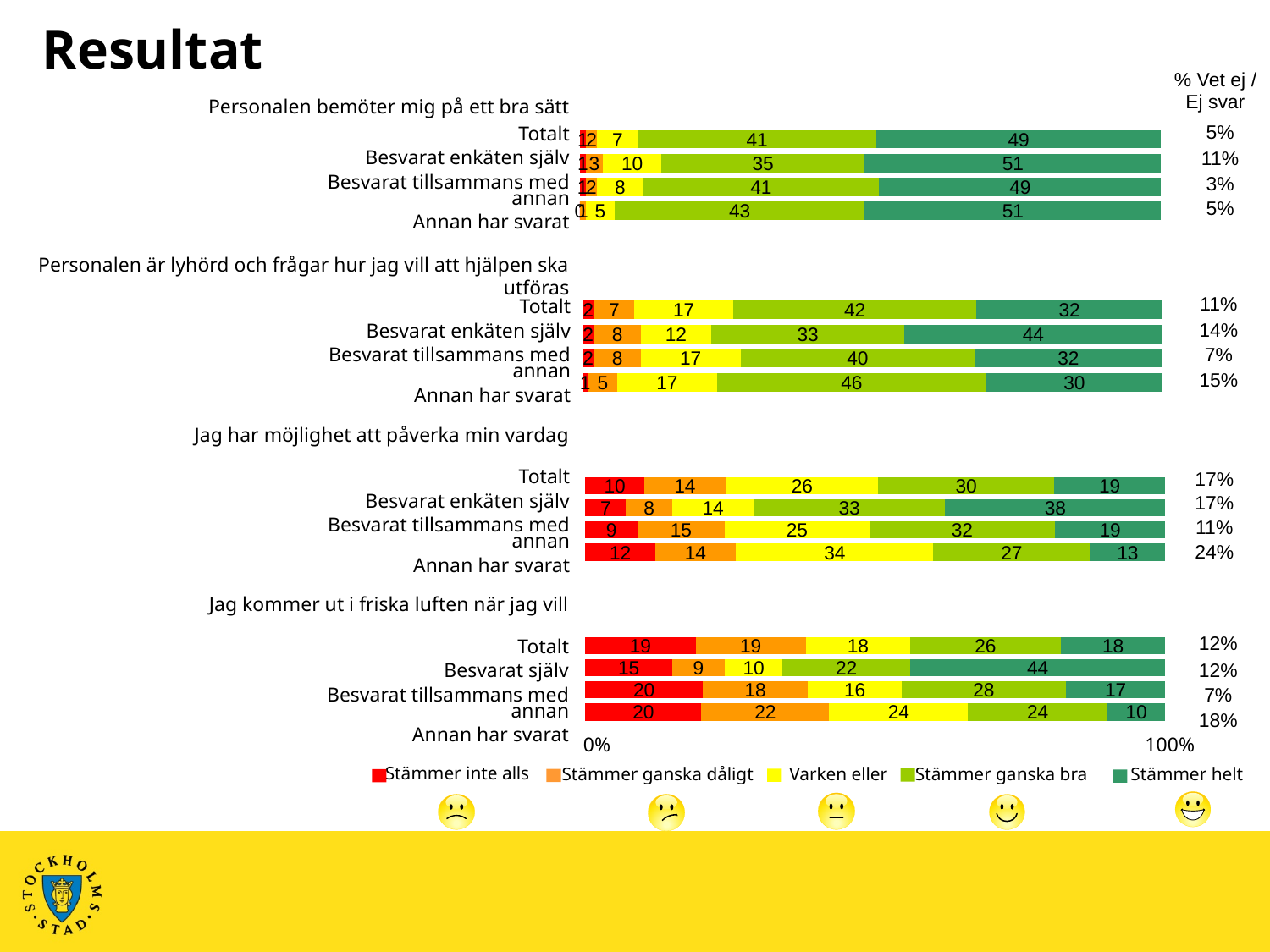
For 'Personalen bemöter mig på ett bra sätt', what is the 'Stämmer helt' value for the Totalt row? 49 What is the '% Vet ej / Ej svar' value for the 'Annan har svarat' row under 'Jag har möjlighet att påverka min vardag'? 24% How many series does the legend list? 5 How many rows (bars) are shown under 'Jag kommer ut i friska luften när jag vill'? 4 For 'Jag har möjlighet att påverka min vardag', what is the 'Varken eller' value for the 'Annan har svarat' row? 34 For 'Personalen är lyhörd och frågar hur jag vill att hjälpen ska utföras', what is the 'Stämmer ganska bra' value for the 'Besvarat enkäten själv' row? 33 For 'Jag kommer ut i friska luften när jag vill', which row has the highest 'Stämmer helt' value? Besvarat själv What kind of chart is shown on the slide? stacked bar chart For 'Jag har möjlighet att påverka min vardag', which is larger: the 'Stämmer helt' value for 'Besvarat enkäten själv' or for 'Annan har svarat'? Besvarat enkäten själv For 'Personalen är lyhörd och frågar hur jag vill att hjälpen ska utföras', what is the difference between the 'Stämmer helt' values for 'Besvarat enkäten själv' and Totalt? 12 Which legend entry is shown in red? Stämmer inte alls For 'Jag kommer ut i friska luften när jag vill', what is the 'Stämmer inte alls' value for the Totalt row? 19